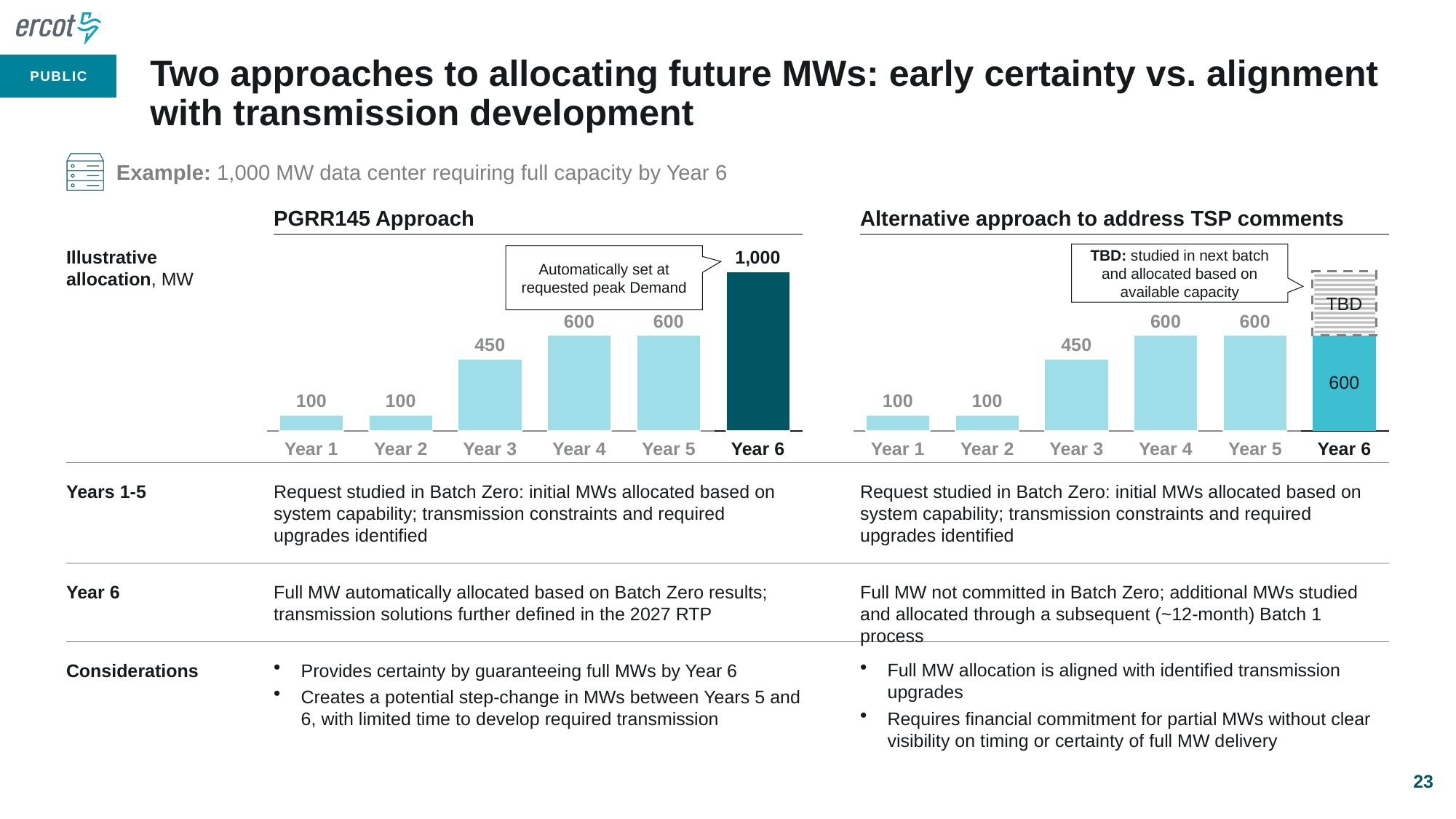
In the PGRR145 Approach chart, what does the callout say the Year 6 value is automatically set at? Requested peak Demand In the Alternative approach to address TSP comments chart, what label is shown on the hatched portion of the Year 6 bar? TBD What kind of chart is the Alternative approach to address TSP comments chart? Bar chart In the PGRR145 Approach chart, what is the difference between the Year 6 and Year 5 values? 400 In the PGRR145 Approach chart, which year has the highest allocation? Year 6 In the PGRR145 Approach chart, what is the value for Year 3? 450 In the PGRR145 Approach chart, do the values rise or fall from Year 1 to Year 6? Rise How many years are shown on the x axis of the PGRR145 Approach chart? 6 In the PGRR145 Approach chart, which is larger, the value for Year 3 or the value for Year 4? Year 4 In the Alternative approach to address TSP comments chart, what is the difference between the Year 3 and Year 2 values? 350 In the Alternative approach to address TSP comments chart, what is the committed value shown for Year 6? 600 In the PGRR145 Approach chart, what is the illustrative allocation for Year 6? 1,000